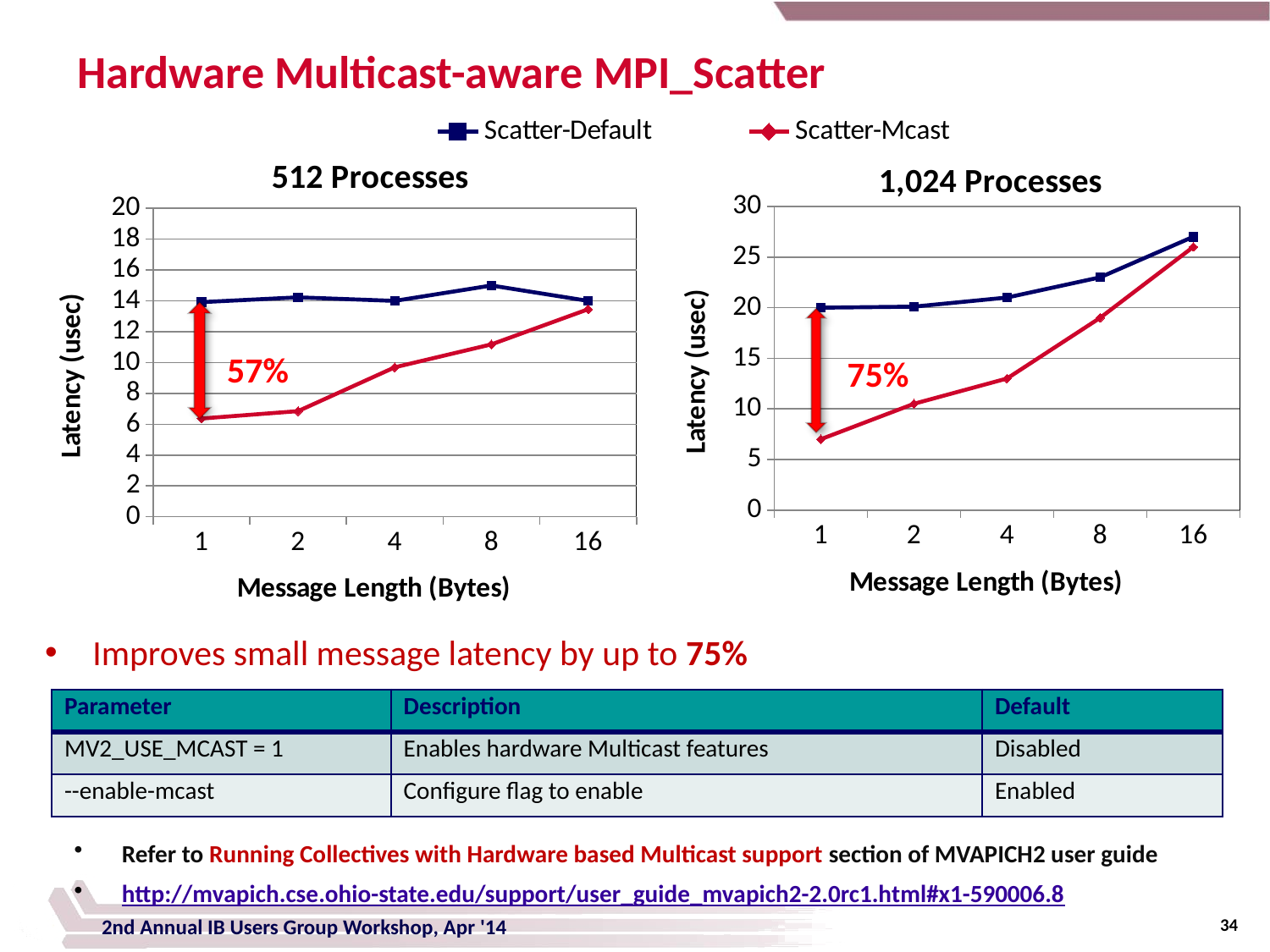
What percentage improvement is annotated on the "1,024 Processes" chart? 75% In the "1,024 Processes" chart, is the Scatter-Default latency at message length 16 greater or less than 25 usec? greater In the "512 Processes" chart, is the Scatter-Mcast latency at message length 1 greater or less than 8 usec? less What percentage improvement is annotated on the "512 Processes" chart? 57% How many series does the legend list for the charts? 2 In the "512 Processes" chart, which series has the higher latency at message length 4 bytes, Scatter-Default or Scatter-Mcast? Scatter-Default What kind of chart is the "512 Processes" chart? line chart In the "1,024 Processes" chart, does the Scatter-Mcast latency rise or fall as message length increases from 1 to 16 bytes? rises How many message length values are plotted on the x axis of the "1,024 Processes" chart? 5 In the "512 Processes" chart, is the Scatter-Default latency at message length 8 greater or less than 14 usec? greater In the "1,024 Processes" chart, at which message length is the Scatter-Mcast latency lowest? 1 In the "1,024 Processes" chart, at which message length is the Scatter-Default latency highest? 16